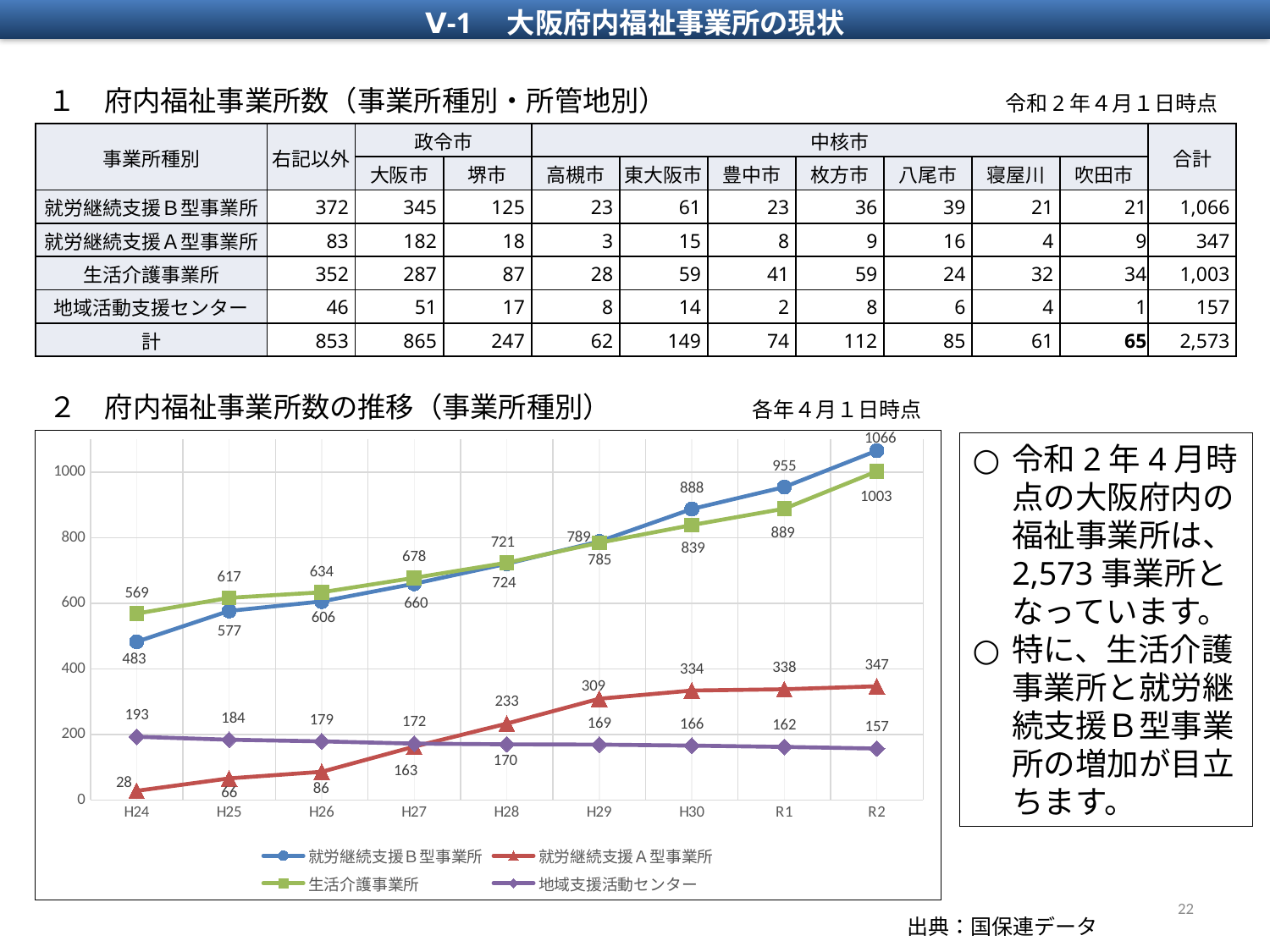
In the line chart, which series has the lowest value at H24? 就労継続支援A型事業所 What kind of chart is shown in section 2 (府内福祉事業所数の推移)? line chart In the line chart, what is the value for 就労継続支援A型事業所 at H24? 28 In the line chart, what is the value for 就労継続支援B型事業所 at R2? 1066 In the line chart, which is larger at H30: 生活介護事業所 or 就労継続支援A型事業所? 生活介護事業所 In the line chart, how many time points are shown on the x axis? 9 In the line chart, which series has the highest value at R2? 就労継続支援B型事業所 In the line chart, does the value for 地域支援活動センター rise or fall from H24 to R2? fall In the line chart, what is the difference between the 就労継続支援B型事業所 values at R2 and H24? 583 In the line chart, how many series does the legend list? 4 In the line chart, what is the value for 生活介護事業所 at H28? 724 In the line chart, what is the value for 地域支援活動センター at R1? 162